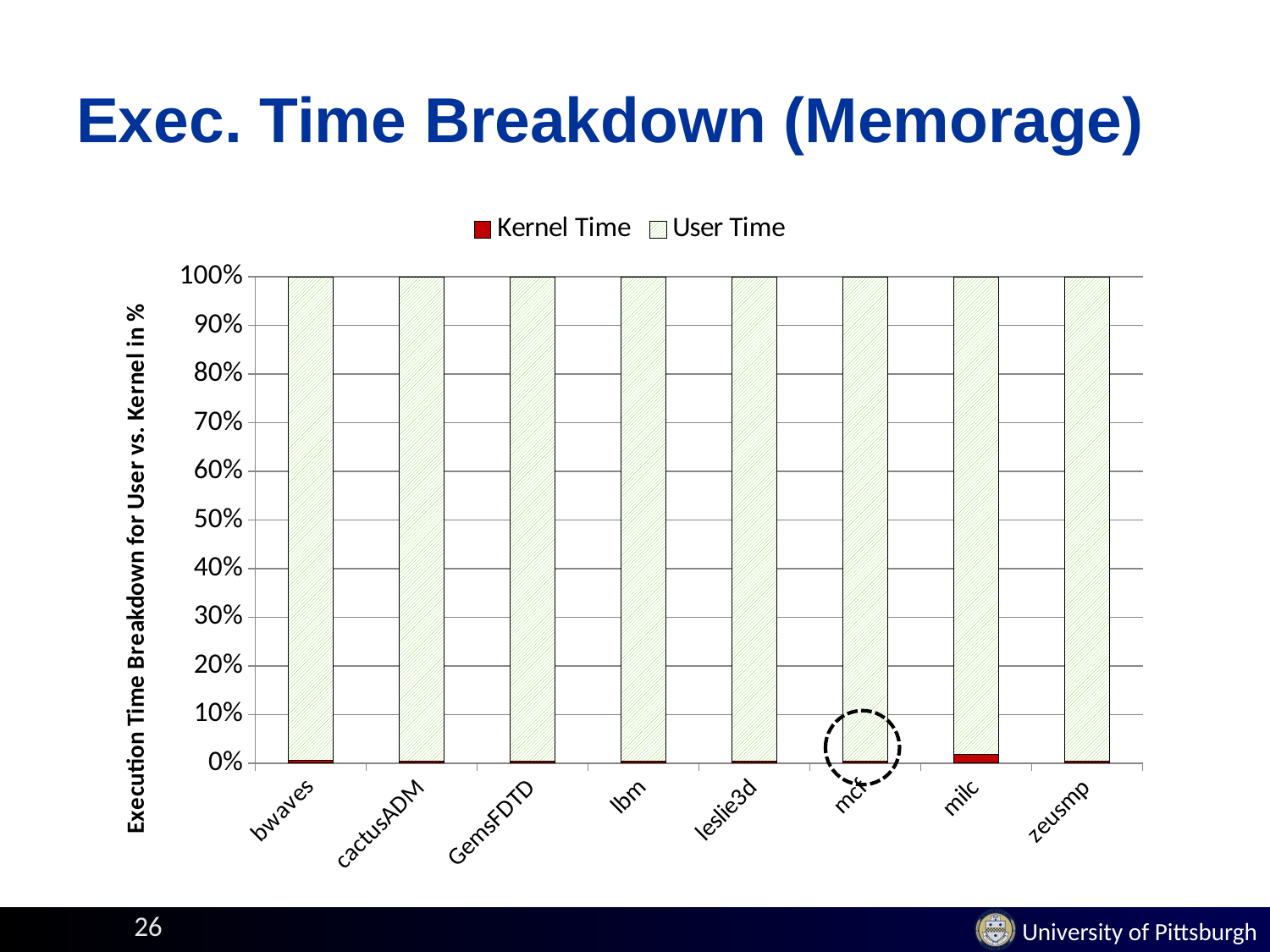
How many benchmark categories are shown on the x axis of the chart? 8 Is the User Time share for bwaves greater or less than 90%? greater Which is larger for milc: the Kernel Time share or the User Time share? User Time How many series does the chart's legend list? 2 Which benchmark on the x axis is circled with a dashed line? mcf What is the title of the slide containing the chart? Exec. Time Breakdown (Memorage) Is the Kernel Time share for milc greater or less than 10%? less Which benchmark has the highest Kernel Time share in the chart? milc Is the Kernel Time share for lbm greater or less than 10%? less What are the two series named in the chart's legend? Kernel Time and User Time What kind of chart is shown on the slide? Stacked bar chart What is the total height of the stacked bar for zeusmp? 100%